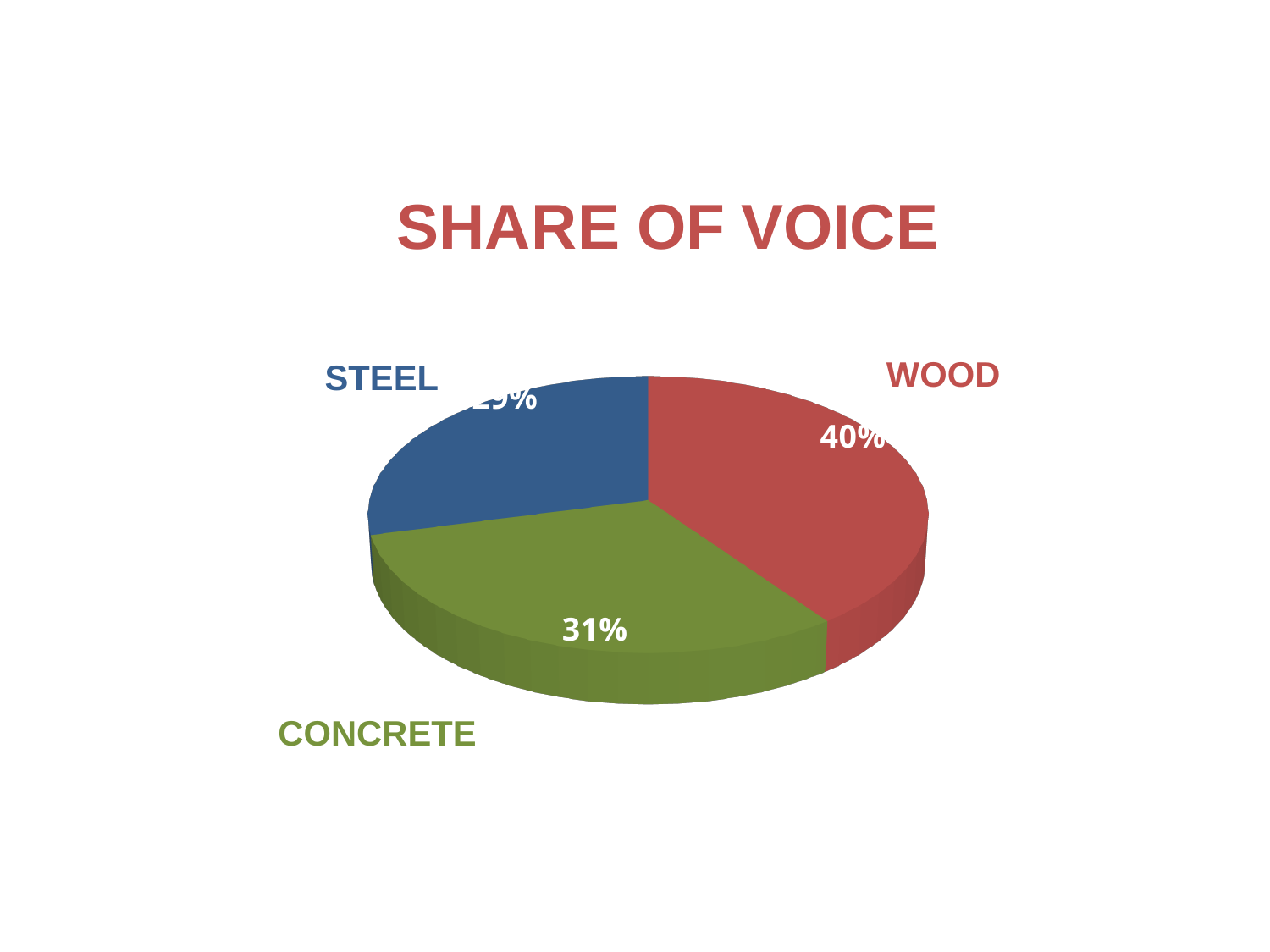
Which is larger, the WOOD slice or the CONCRETE slice? WOOD What share of the pie does CONCRETE represent? 31% What percentage is shown for WOOD? 40% What colour is the WOOD slice? red How many percentage points larger is WOOD than CONCRETE? 9 percentage points What is the title of the chart? SHARE OF VOICE Which category has the largest slice of the pie? WOOD How many categories are shown in the pie chart? 3 What kind of chart is shown on the slide? pie chart What percentage is shown for CONCRETE? 31%